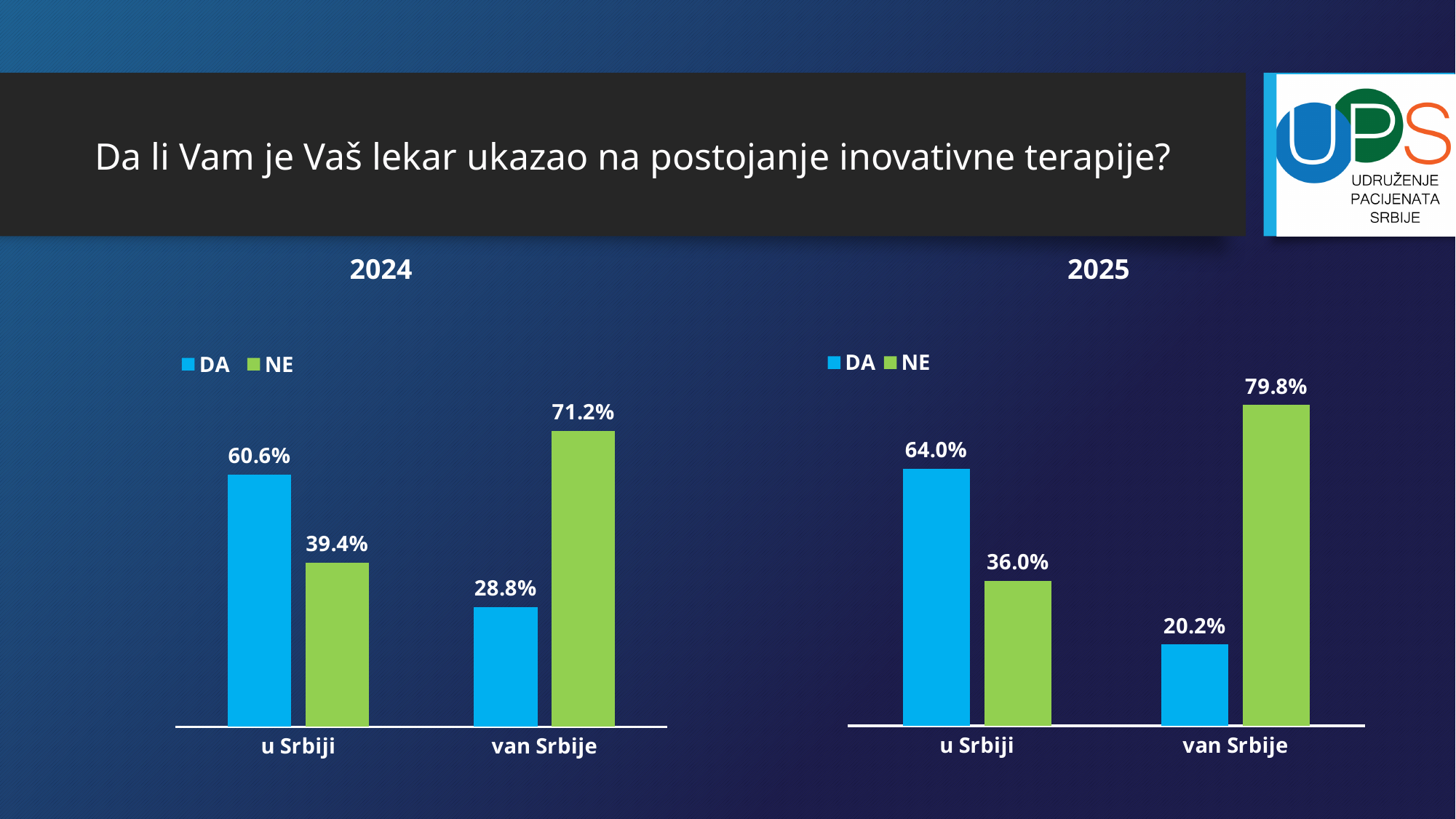
In the 2025 chart, what is the value for DA for van Srbije? 20.2% In the 2025 chart, which is larger for u Srbiji, DA or NE? DA In the 2025 chart, what is the difference between NE and DA for van Srbije? 59.6% In the 2025 chart, which bar is the highest? NE for van Srbije How many series does the legend of the 2024 chart list? 2 In the 2024 chart, which bar is the lowest? DA for van Srbije What kind of chart is the 2024 chart? Bar chart In the 2024 chart, what is the value for DA for u Srbiji? 60.6% In the 2024 chart, what is the value for NE for van Srbije? 71.2% In the 2025 chart, what is the value for NE for u Srbiji? 36.0% How many categories are shown on the x axis of the 2025 chart? 2 In the 2024 chart, what is the difference between DA and NE for u Srbiji? 21.2%